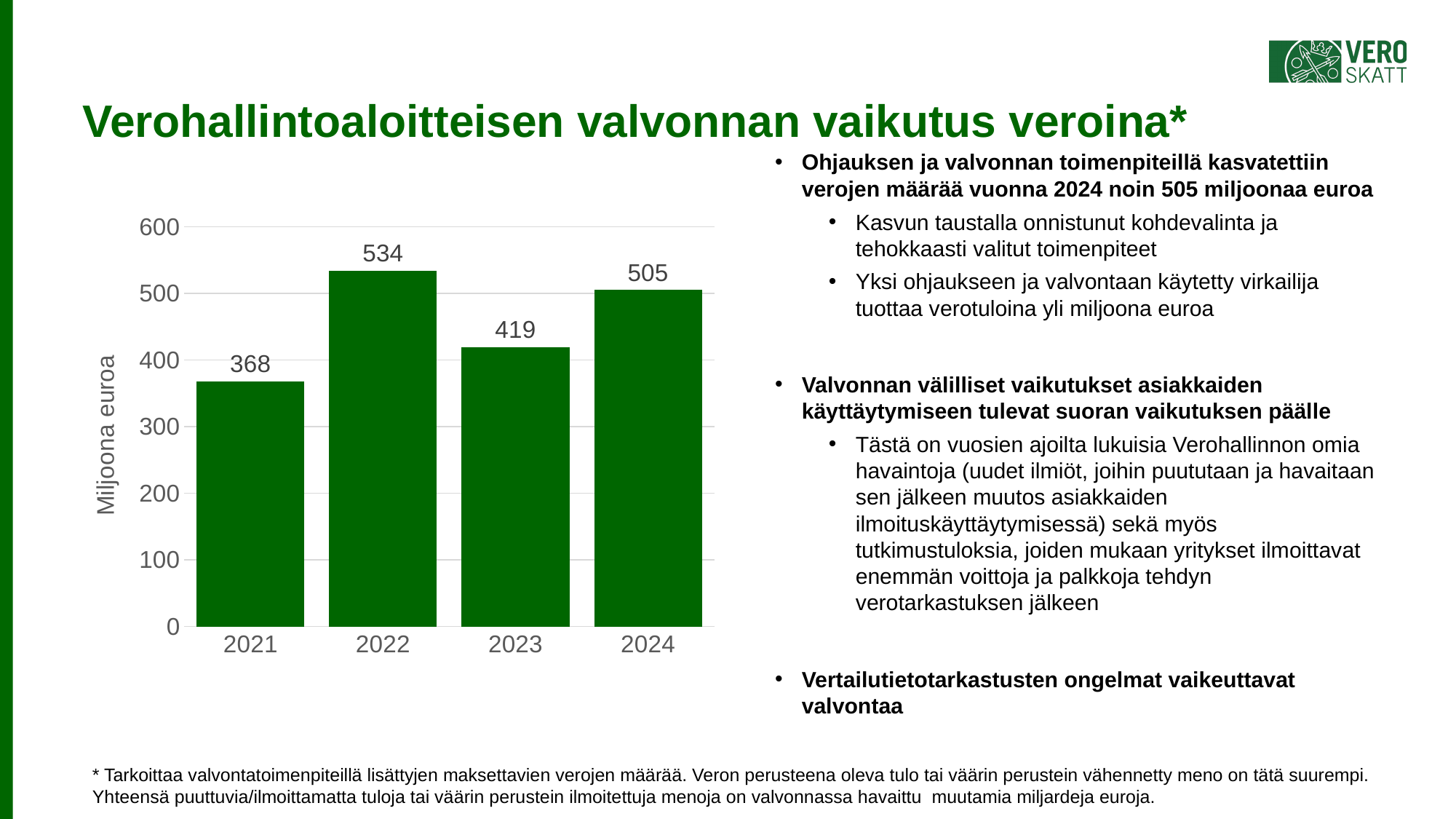
How many years are shown on the x axis? 4 Which is larger, the value for 2023 or the value for 2024? 2024 What is the difference between the values for 2024 and 2023? 86 What kind of chart is shown on the slide? Bar chart What is the difference between the values for 2022 and 2021? 166 What is the label of the y axis? Miljoona euroa Which year has the highest value? 2022 What is the value for 2024? 505 What is the value for 2022? 534 What is the value for 2021? 368 Which year has the lowest value? 2021 What is the value for 2023? 419